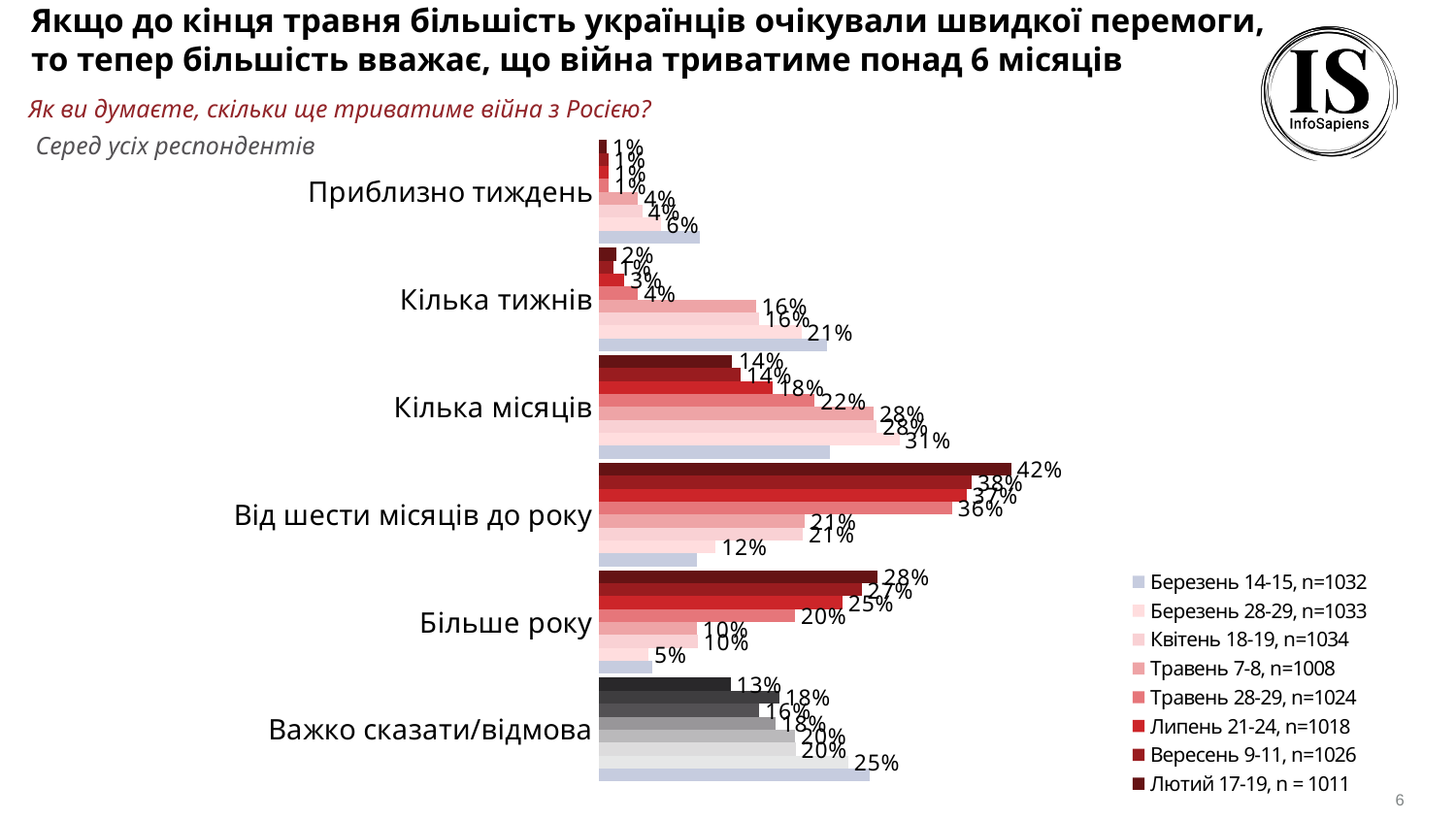
For 'Від шести місяців до року', do the values increase or decrease from the earliest wave to the latest wave? increase What kind of chart is shown on the slide? bar chart In the Лютий 17-19 wave, what is the difference between 'Від шести місяців до року' and 'Більше року'? 14 percentage points What is the value for 'Від шести місяців до року' in the Лютий 17-19 wave? 42% How many series does the legend list? 8 How many answer categories are shown on the chart? 6 Which answer category has the highest value in the Лютий 17-19 wave? Від шести місяців до року What is the value for 'Більше року' in the Лютий 17-19 wave? 28% What is the first entry listed in the legend? Березень 14-15, n=1032 What is the value for 'Важко сказати/відмова' in the Лютий 17-19 wave? 13% In the Лютий 17-19 wave, which is larger: 'Від шести місяців до року' or 'Більше року'? Від шести місяців до року What sample size (n) is given in the legend for the Лютий 17-19 wave? 1011